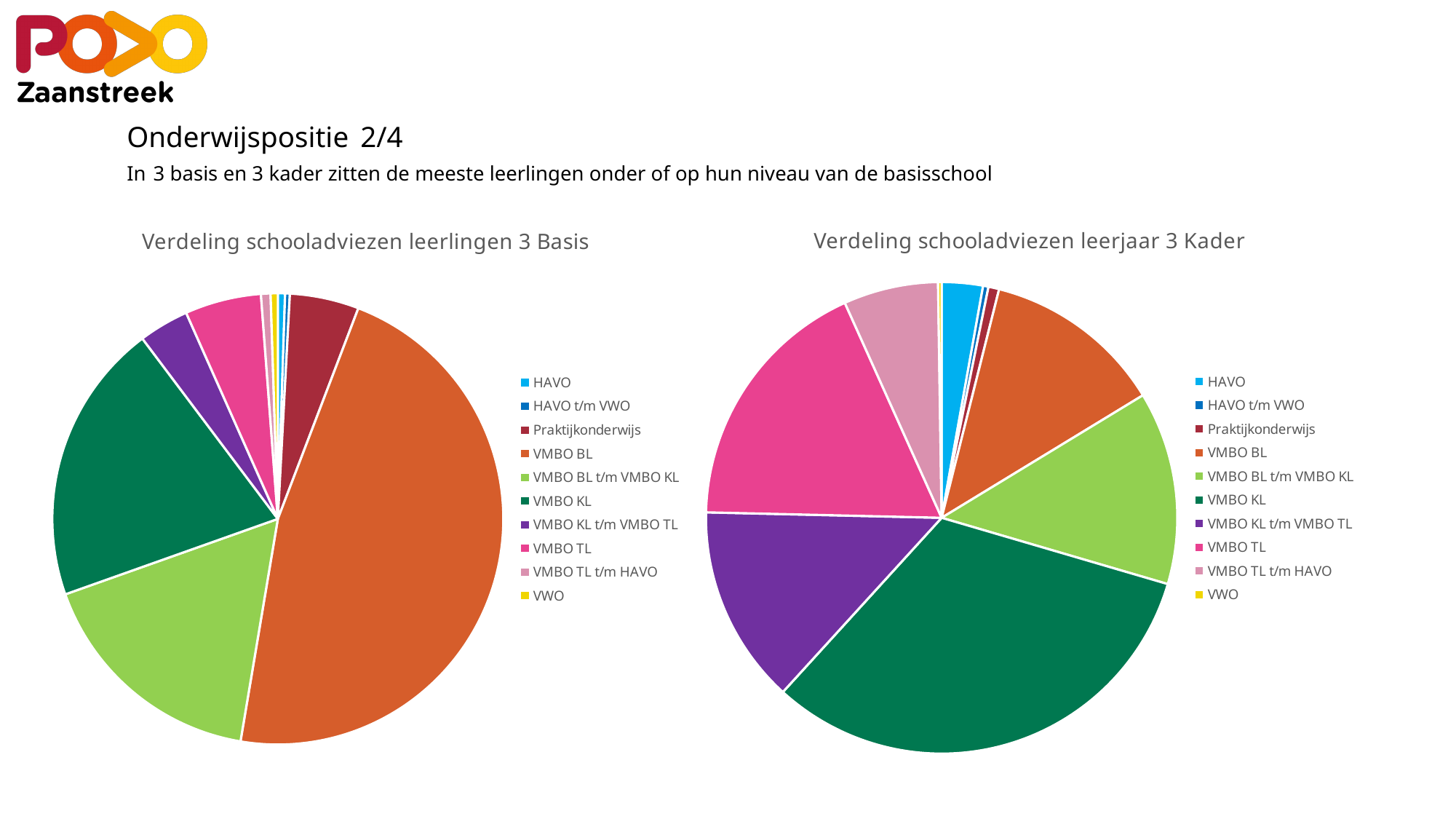
In the right chart, 'Verdeling schooladviezen leerjaar 3 Kader', which slice is larger: HAVO or VMBO TL t/m HAVO? VMBO TL t/m HAVO In the left chart, 'Verdeling schooladviezen leerlingen 3 Basis', which slice is larger: VMBO KL or VMBO TL? VMBO KL What is the title of the left chart? Verdeling schooladviezen leerlingen 3 Basis What kind of chart is the left chart, 'Verdeling schooladviezen leerlingen 3 Basis'? Pie chart In the left chart, 'Verdeling schooladviezen leerlingen 3 Basis', which category has the largest slice? VMBO BL In the right chart, 'Verdeling schooladviezen leerjaar 3 Kader', which slice is larger: VMBO TL or VMBO BL? VMBO TL What kind of chart is the right chart, 'Verdeling schooladviezen leerjaar 3 Kader'? Pie chart In the right chart, 'Verdeling schooladviezen leerjaar 3 Kader', which category has the largest slice? VMBO KL How many categories does the legend of the right chart, 'Verdeling schooladviezen leerjaar 3 Kader', list? 10 In the right chart, 'Verdeling schooladviezen leerjaar 3 Kader', what colour is the VMBO KL slice? Dark green How many categories does the legend of the left chart, 'Verdeling schooladviezen leerlingen 3 Basis', list? 10